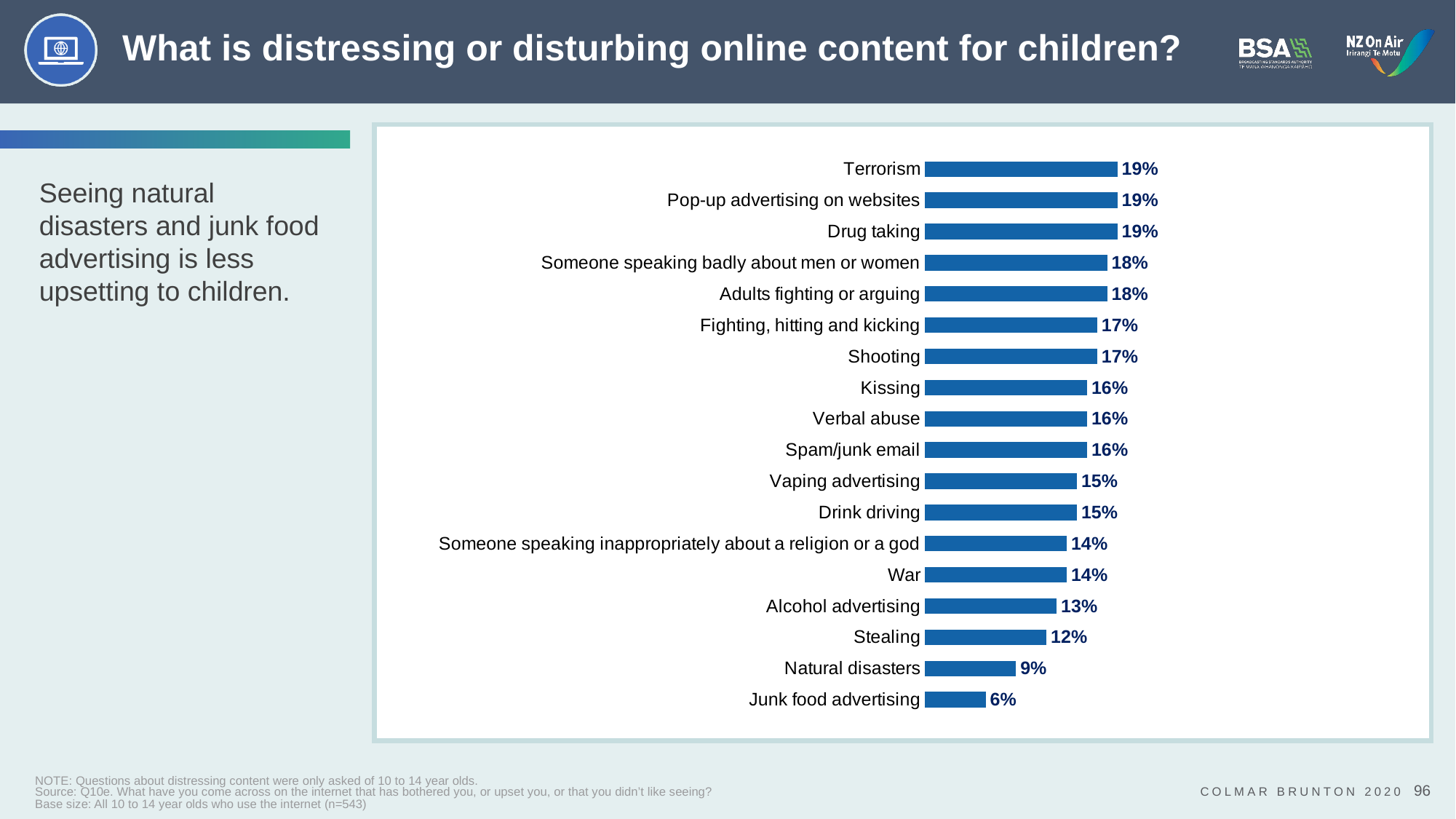
What is the difference between the values for Natural disasters and Junk food advertising? 3% What is the value for Someone speaking inappropriately about a religion or a god? 14% What percentage is shown for Terrorism? 19% What is the value shown for Natural disasters? 9% What percentage of children said junk food advertising was distressing or disturbing online content? 6% What type of chart is shown on the slide? Bar chart How many categories are shown in the chart? 18 What is the difference between the values for Drug taking and Stealing? 7% Which has a higher value, Shooting or War? Shooting What percentage is shown for Vaping advertising? 15% Which category has the lowest value in the chart? Junk food advertising Which has a higher value, Alcohol advertising or Kissing? Kissing